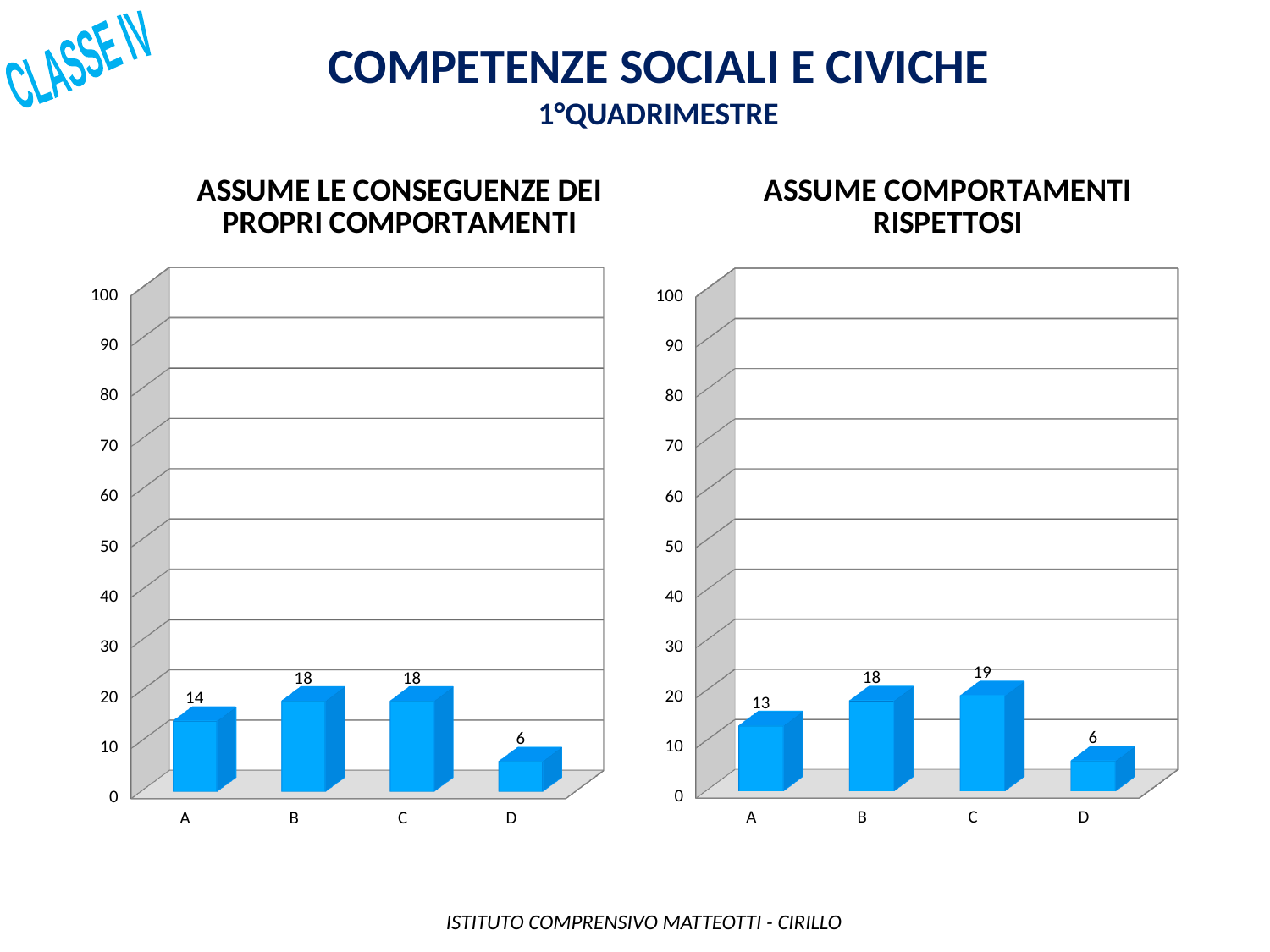
What kind of chart is the chart titled "ASSUME COMPORTAMENTI RISPETTOSI"? Bar chart In the chart titled "ASSUME COMPORTAMENTI RISPETTOSI", is the value for B greater or less than 10? greater In the chart titled "ASSUME LE CONSEGUENZE DEI PROPRI COMPORTAMENTI", what is the value for category A? 14 In the chart titled "ASSUME COMPORTAMENTI RISPETTOSI", which category has the highest value? C How many categories are shown in the chart titled "ASSUME LE CONSEGUENZE DEI PROPRI COMPORTAMENTI"? 4 In the chart titled "ASSUME COMPORTAMENTI RISPETTOSI", what is the difference between the values for C and A? 6 In the chart titled "ASSUME COMPORTAMENTI RISPETTOSI", what is the value for category C? 19 In the chart titled "ASSUME LE CONSEGUENZE DEI PROPRI COMPORTAMENTI", which is larger, the value for A or the value for D? A In the chart titled "ASSUME COMPORTAMENTI RISPETTOSI", what is the value for category A? 13 What is the maximum value shown on the vertical axis of the chart titled "ASSUME LE CONSEGUENZE DEI PROPRI COMPORTAMENTI"? 100 In the chart titled "ASSUME LE CONSEGUENZE DEI PROPRI COMPORTAMENTI", which category has the lowest value? D In the chart titled "ASSUME LE CONSEGUENZE DEI PROPRI COMPORTAMENTI", what is the difference between the values for B and D? 12